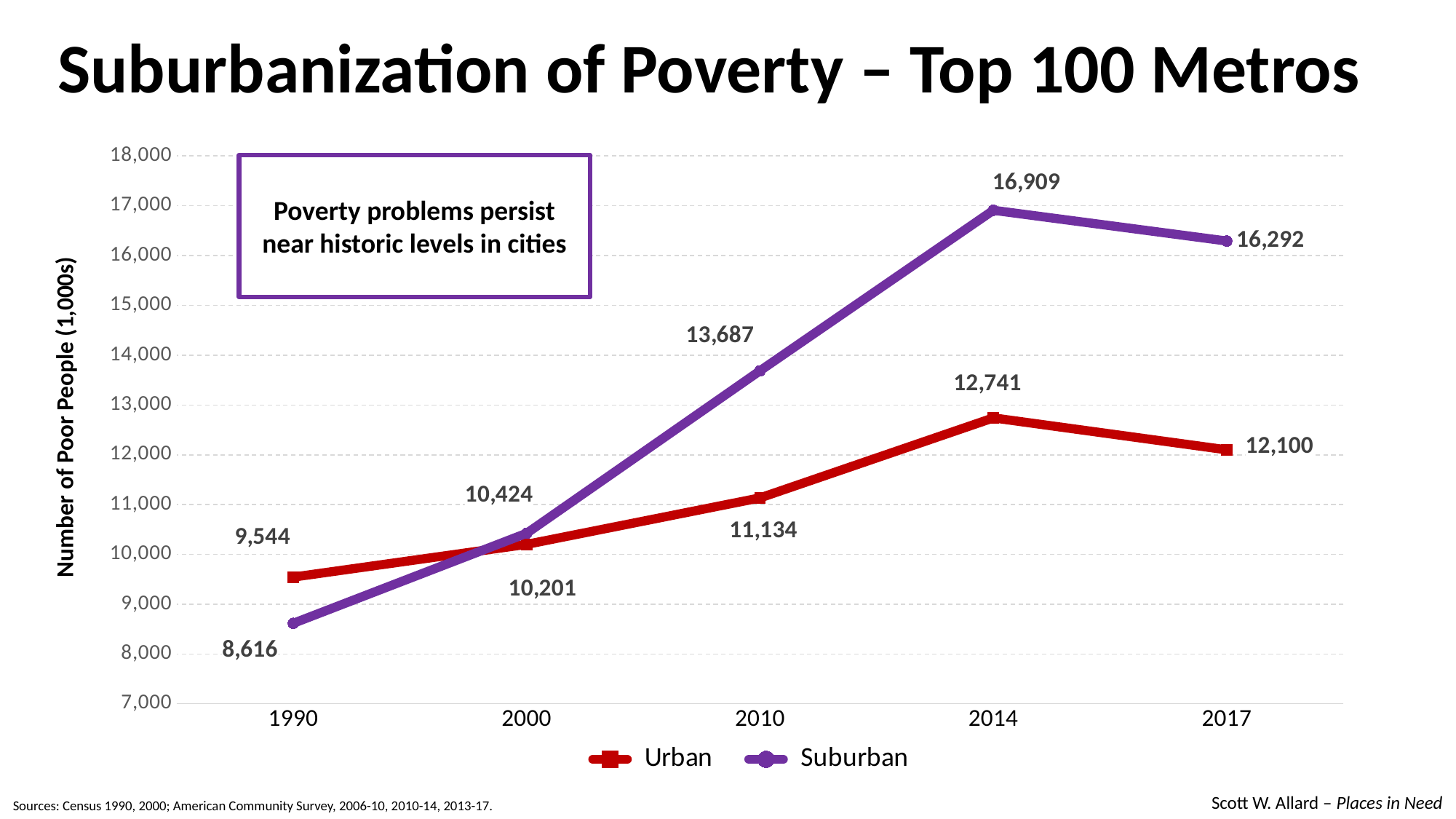
In which year is the Suburban series lowest? 1990 How many years are plotted on the x axis? 5 What kind of chart is shown on the slide? Line chart Which series has the larger value in 1990, Urban or Suburban? Urban How many series does the legend list? 2 What is the difference between the Urban and Suburban values in 1990? 928 What is the difference between the Suburban and Urban values in 2017? 4,192 What is the Suburban value for 2010? 13,687 In which year is the Suburban series highest? 2014 What is the Urban value for 1990? 9,544 What is the Urban value for 2017? 12,100 What is the Suburban value for 2014? 16,909